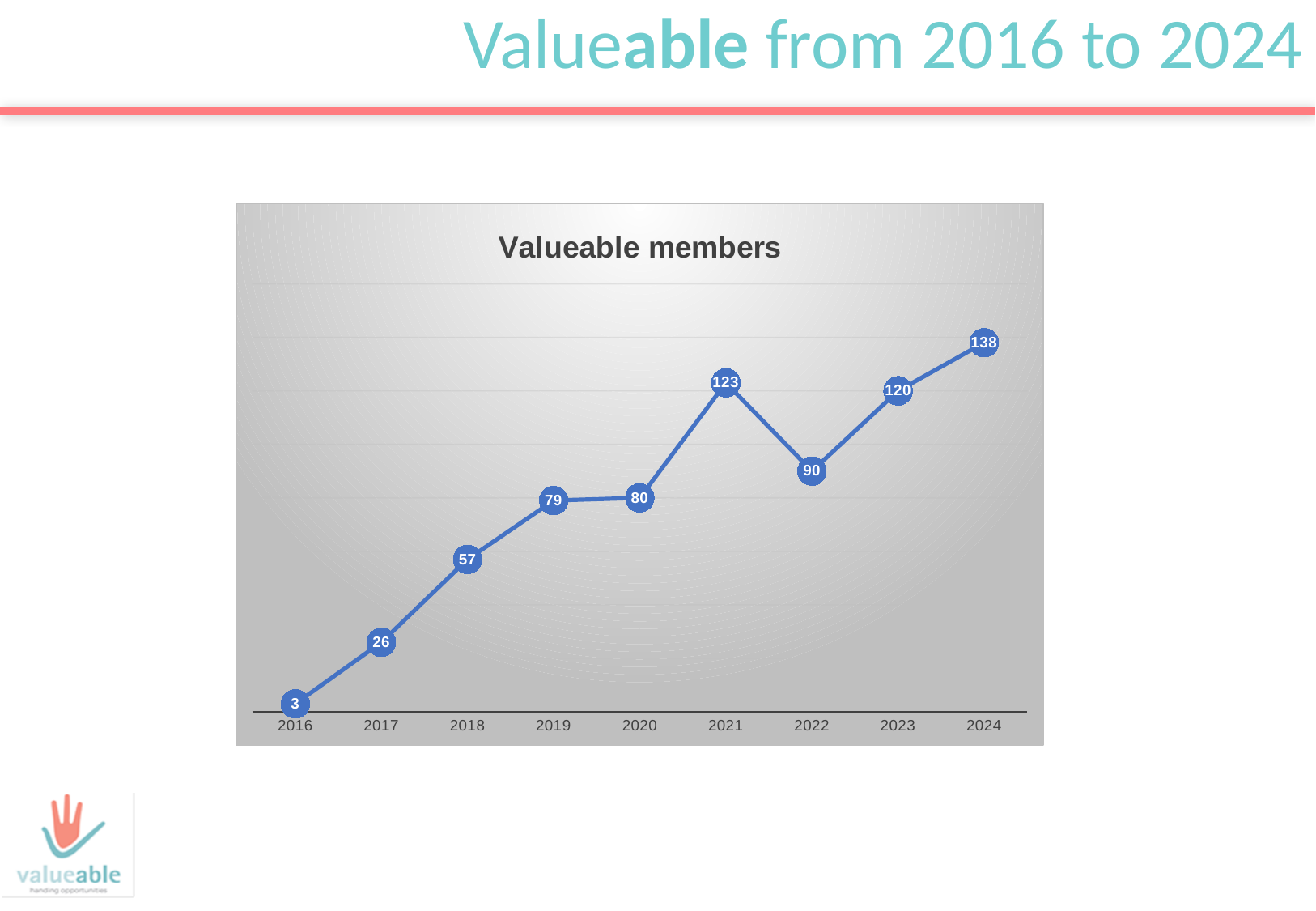
What is the difference in Valueable members between 2021 and 2022? 33 What is the number of Valueable members in 2022? 90 What is the number of Valueable members in 2016? 3 Which year had more Valueable members, 2019 or 2020? 2020 Which year had more Valueable members, 2021 or 2023? 2021 What is the number of Valueable members in 2021? 123 How many years are plotted on the chart? 9 Which year has the highest number of Valueable members? 2024 What is the difference in Valueable members between 2024 and 2023? 18 What is the title of the chart? Valueable members Which year has the lowest number of Valueable members? 2016 What kind of chart is shown on the slide? Line chart